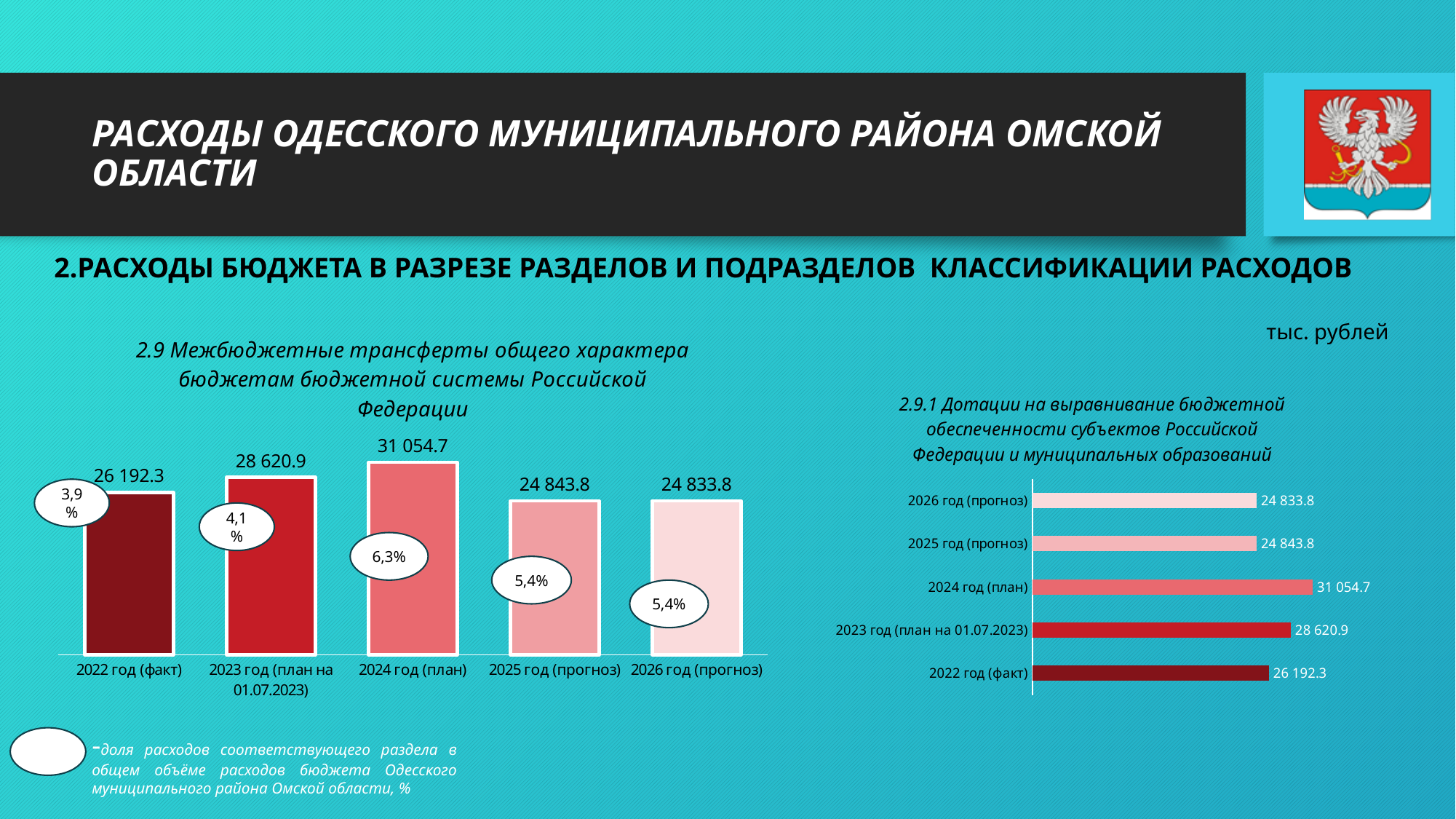
What unit of measurement is indicated on the slide for the chart values? тыс. рублей What type of chart is the right chart (2.9.1 Дотации на выравнивание бюджетной обеспеченности)? bar chart In the left chart (2.9 Межбюджетные трансферты общего характера), what share percentage is shown in the oval for 2024 год (план)? 6,3% In the left chart (2.9 Межбюджетные трансферты общего характера), which category has the highest value? 2024 год (план) In the right chart (2.9.1 Дотации на выравнивание бюджетной обеспеченности), what is the difference between the values for 2025 год (прогноз) and 2026 год (прогноз)? 10.0 In the left chart (2.9 Межбюджетные трансферты общего характера), which category has the lowest value? 2026 год (прогноз) In the right chart (2.9.1 Дотации на выравнивание бюджетной обеспеченности), which is larger: the value for 2025 год (прогноз) or 2022 год (факт)? 2022 год (факт) In the left chart (2.9 Межбюджетные трансферты общего характера), how many bars are plotted? 5 In the right chart (2.9.1 Дотации на выравнивание бюджетной обеспеченности), what is the value for 2023 год (план на 01.07.2023)? 28 620.9 In the left chart (2.9 Межбюджетные трансферты общего характера), what is the value for 2022 год (факт)? 26 192.3 In the left chart (2.9 Межбюджетные трансферты общего характера), what is the value for 2024 год (план)? 31 054.7 In the left chart (2.9 Межбюджетные трансферты общего характера), what is the difference between the values for 2024 год (план) and 2023 год (план на 01.07.2023)? 2 433.8